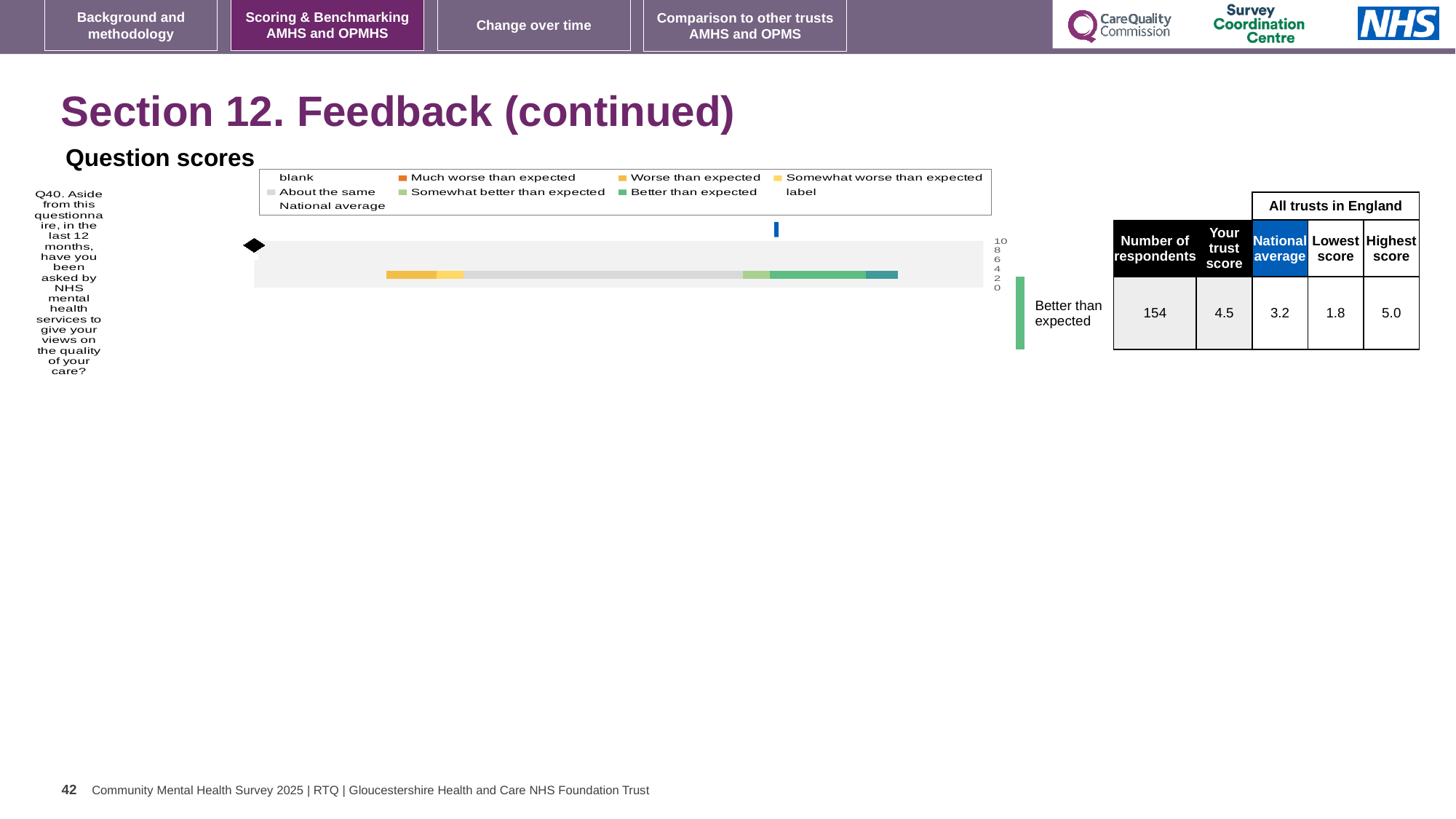
In the table beside the chart, how many respondents answered Q40? 154 What is the highest tick value shown on the axis of the Question scores chart? 10 In the table beside the chart, what is the national average for Q40? 3.2 In the table beside the chart, what is the difference between the highest score and the lowest score for Q40? 3.2 Which question number is plotted in the Question scores chart? Q40 How many questions (categories) are plotted in the Question scores chart? 1 In the table beside the chart, what is the trust score for Q40? 4.5 How many entries does the legend of the Question scores chart list? 9 What kind of chart is shown under 'Question scores'? bar chart In the table beside the chart, which is larger for Q40: the trust score or the national average? trust score According to the label to the right of the chart, how is the trust's result for Q40 categorised? Better than expected